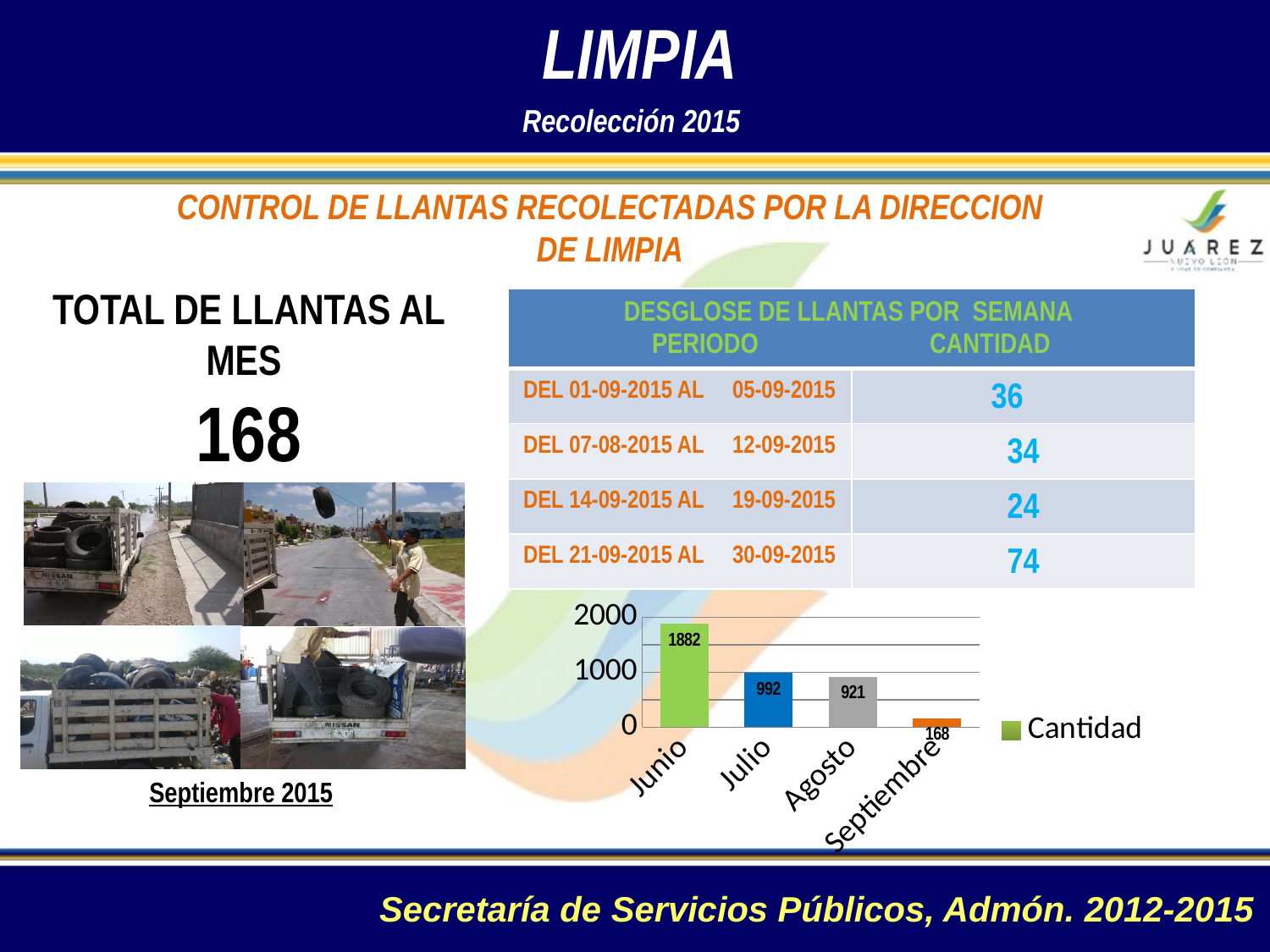
What is the value for Junio in the bar chart? 1882 What is the value for Agosto in the bar chart? 921 What kind of chart is shown on the slide? bar chart What series name does the legend of the bar chart show? Cantidad Which month has the lowest value in the bar chart? Septiembre Which month has the highest value in the bar chart? Junio What is the value for Julio in the bar chart? 992 How many months are shown in the bar chart? 4 Is the value for Junio in the bar chart greater or less than 1000? greater Which is larger in the bar chart, the value for Julio or the value for Agosto? Julio What is the difference between the values for Junio and Julio in the bar chart? 890 What is the value for Septiembre in the bar chart? 168